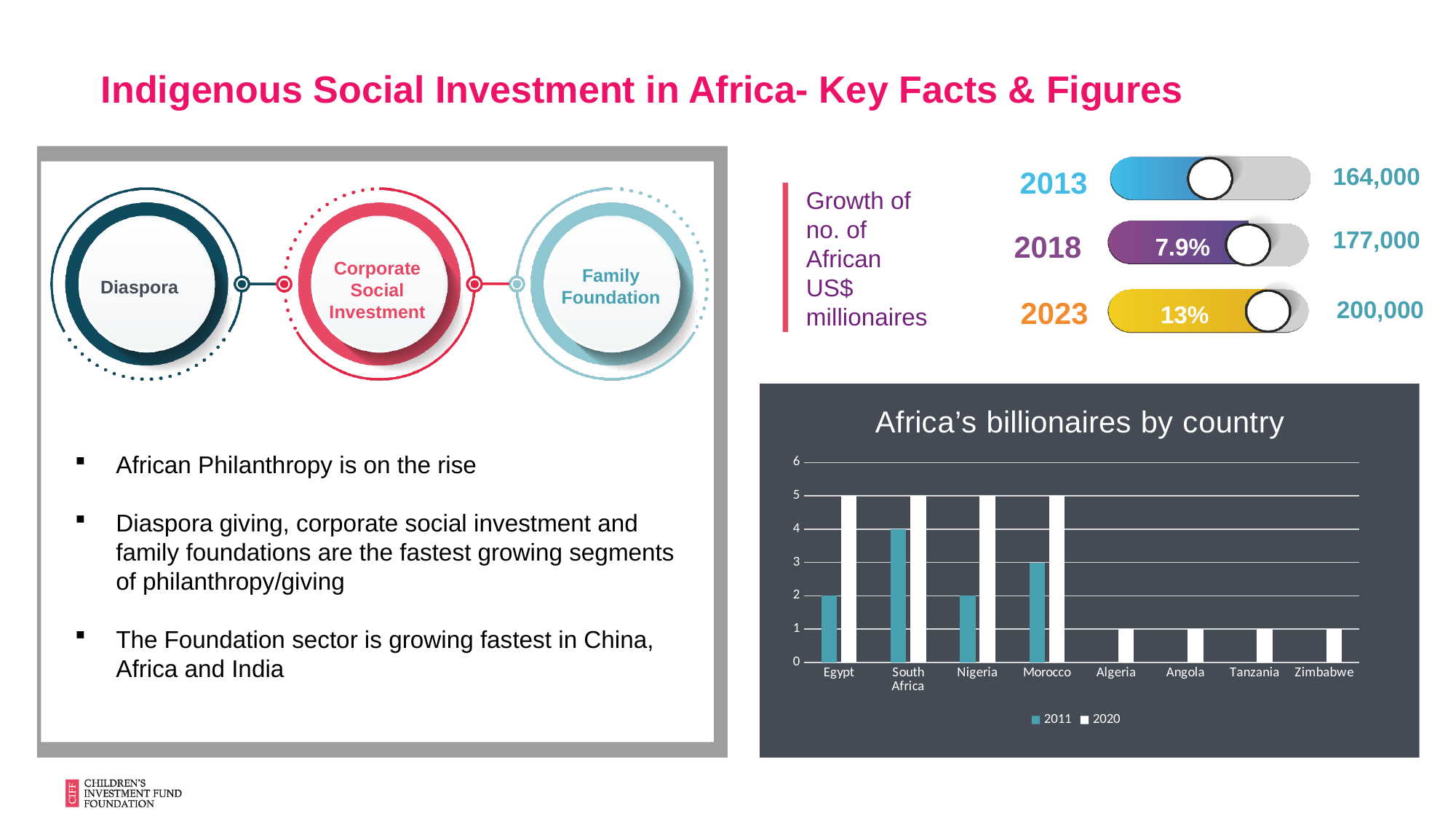
In the 'Africa's billionaires by country' chart, what is the difference between the 2020 and 2011 values for Egypt? 3 How many countries are shown on the x axis of the 'Africa's billionaires by country' chart? 8 In the 'Africa's billionaires by country' chart, what is the 2020 value for Morocco? 5 In the 'Africa's billionaires by country' chart, is the 2011 value for Morocco larger or the 2011 value for Nigeria? Morocco In the 'Africa's billionaires by country' chart, what is the 2020 value for Zimbabwe? 1 What are the two legend entries in the 'Africa's billionaires by country' chart? 2011 and 2020 How many series does the legend of the 'Africa's billionaires by country' chart list? 2 In the 'Africa's billionaires by country' chart, what is the 2011 value for South Africa? 4 What kind of chart is 'Africa's billionaires by country'? bar chart In the 'Africa's billionaires by country' chart, is the 2020 value for Nigeria greater or less than 4? greater In the 'Africa's billionaires by country' chart, what is the 2011 value for Morocco? 3 In the 'Africa's billionaires by country' chart, which country has the highest 2011 value? South Africa